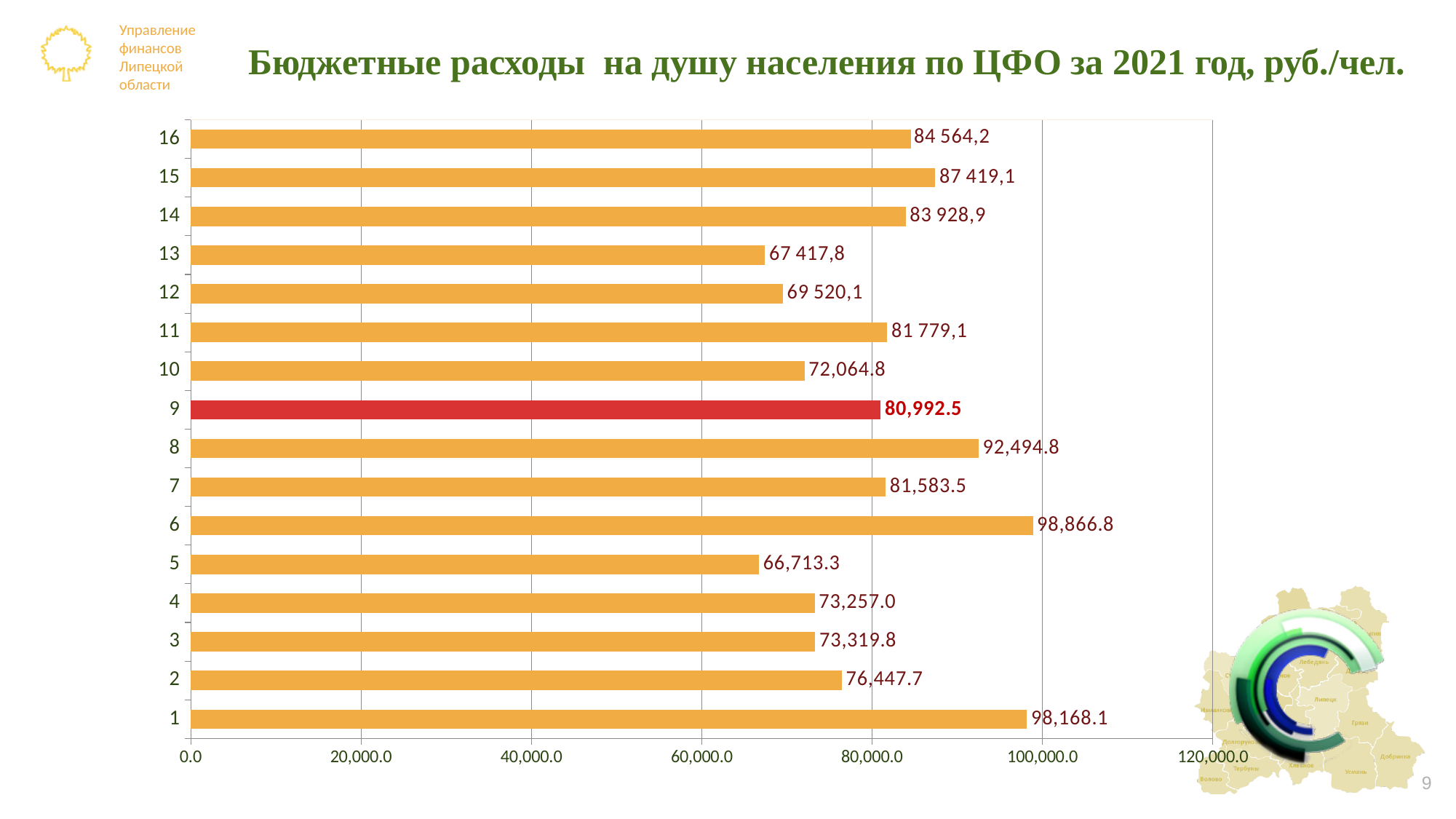
What is the value for category 5? 66,713.3 What is the title of the chart? Бюджетные расходы на душу населения по ЦФО за 2021 год, руб./чел. How many categories are shown on the chart? 16 Which category has the highest value? 6 Which is larger, the value for category 15 or the value for category 14? 15 Which category's bar is highlighted in red? 9 Which category has the lowest value? 5 What is the value for category 16? 84 564,2 Is the value for category 12 greater or less than 80,000.0? less What kind of chart is shown on the slide? bar chart What is the value for category 9? 80,992.5 What is the difference between the values for category 8 and category 9? 11,502.3